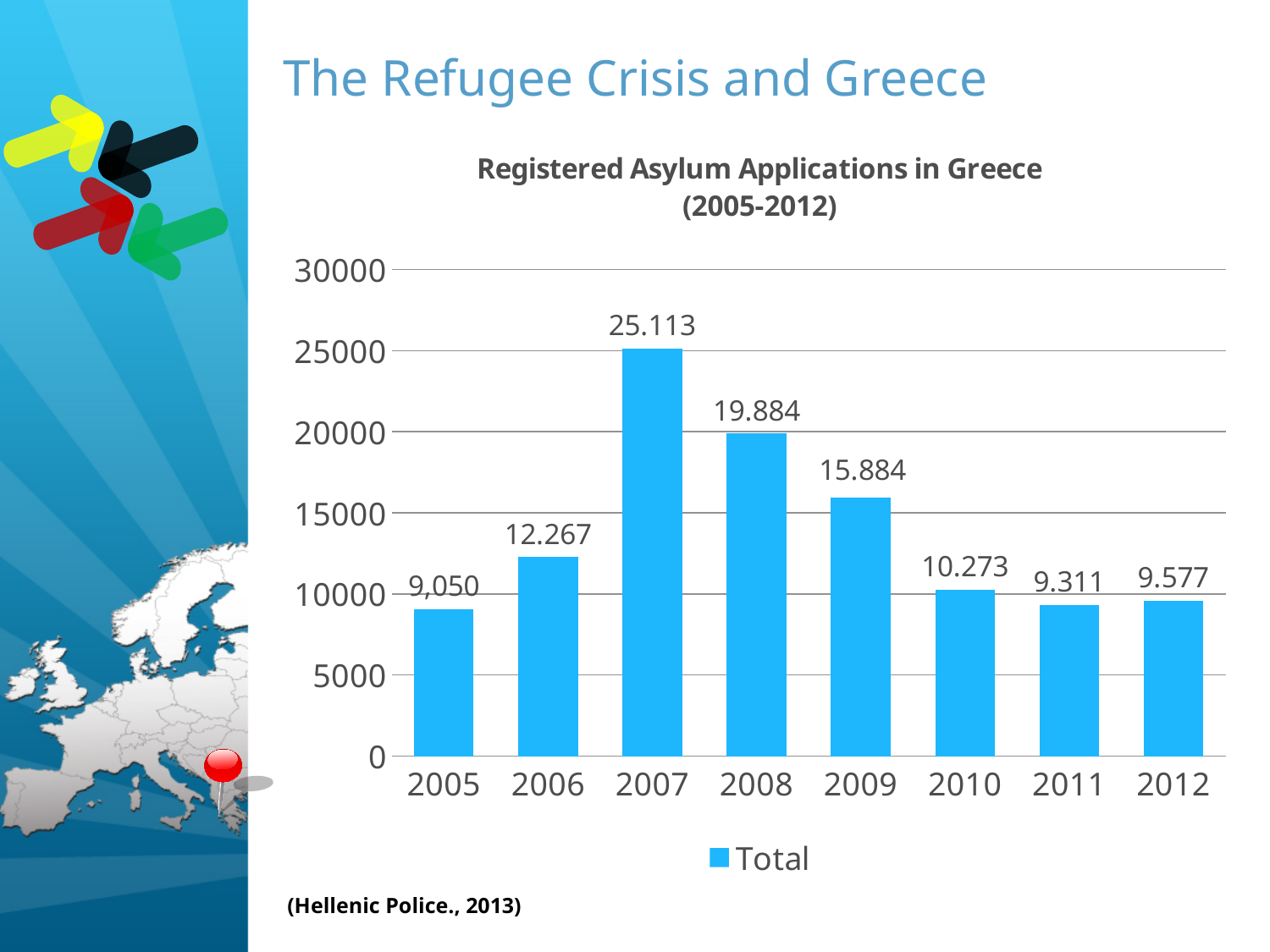
What is the value for 2010 in the chart? 10.273 What is the value for 2005 in the chart? 9,050 What kind of chart is shown on the slide? bar chart Which year has the highest number of registered asylum applications? 2007 Which year has the lowest number of registered asylum applications? 2005 Which is larger, the value for 2006 or the value for 2011? 2006 Do the values rise or fall from 2007 to 2012? fall What is the difference between the values for 2007 and 2008? 5.229 What is the value for 2012 in the chart? 9.577 How many years are shown on the x axis of the chart? 8 What is the value for 2007 in the Registered Asylum Applications in Greece chart? 25.113 Is the value for 2009 greater or less than 15000? greater